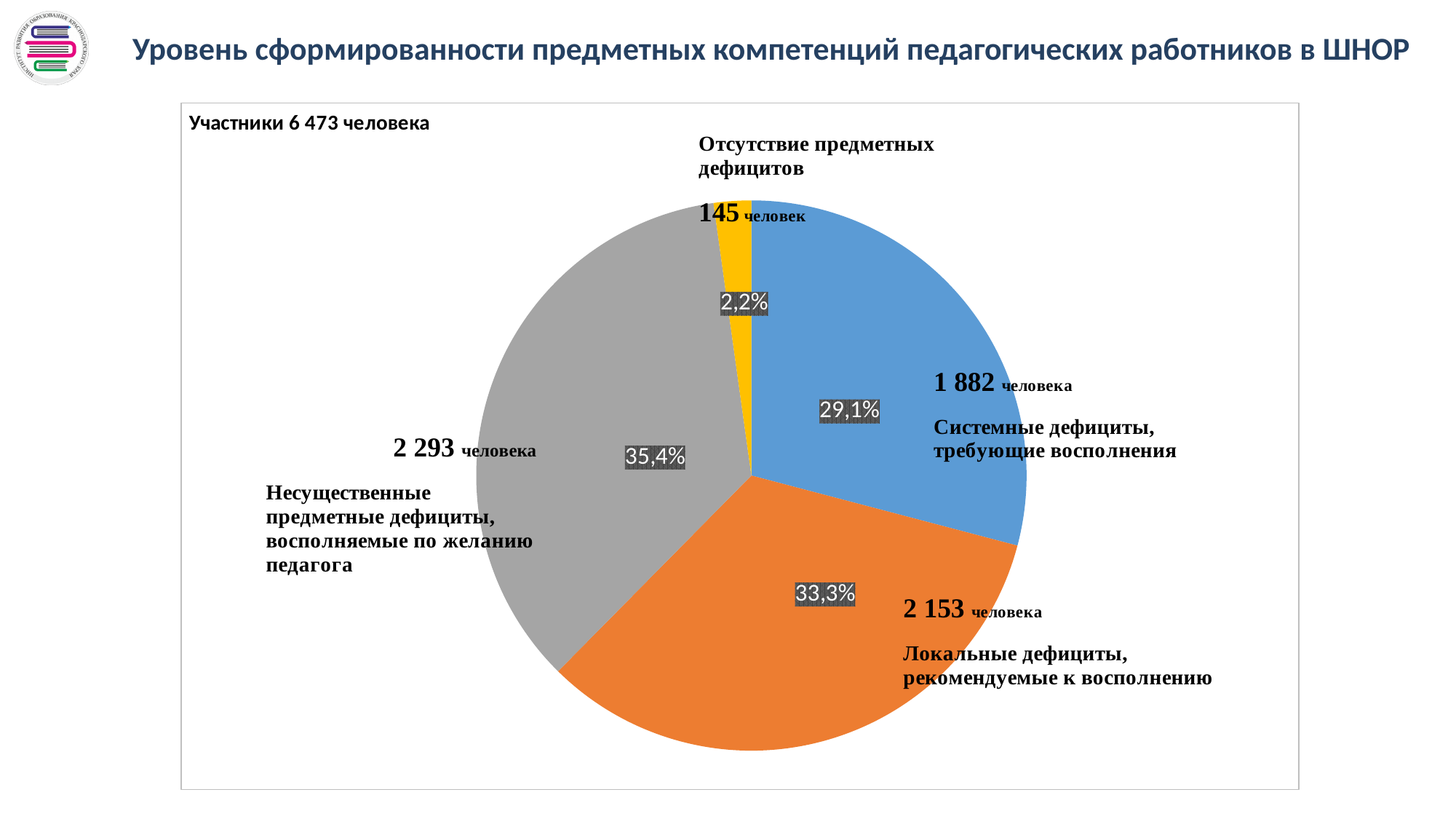
Каким цветом показан сектор «Отсутствие предметных дефицитов»? Жёлтым Сколько всего участников указано на диаграмме? 6 473 человека Какая категория имеет наименьшую долю на диаграмме? Отсутствие предметных дефицитов Какая доля участников имеет локальные дефициты, рекомендуемые к восполнению? 33,3% Что больше: доля системных дефицитов или доля локальных дефицитов? Локальные дефициты (33,3%) Какая доля участников приходится на несущественные предметные дефициты, восполняемые по желанию педагога? 35,4% Сколько человек показано в категории «Отсутствие предметных дефицитов»? 145 человек На сколько человек больше в категории «Локальные дефициты, рекомендуемые к восполнению», чем в категории «Системные дефициты, требующие восполнения»? 271 Какая категория имеет наибольшую долю на диаграмме? Несущественные предметные дефициты, восполняемые по желанию педагога Сколько человек имеют системные дефициты, требующие восполнения? 1 882 человека Сколько категорий (секторов) показано на круговой диаграмме? 4 Какой тип диаграммы показан на слайде? Круговая диаграмма